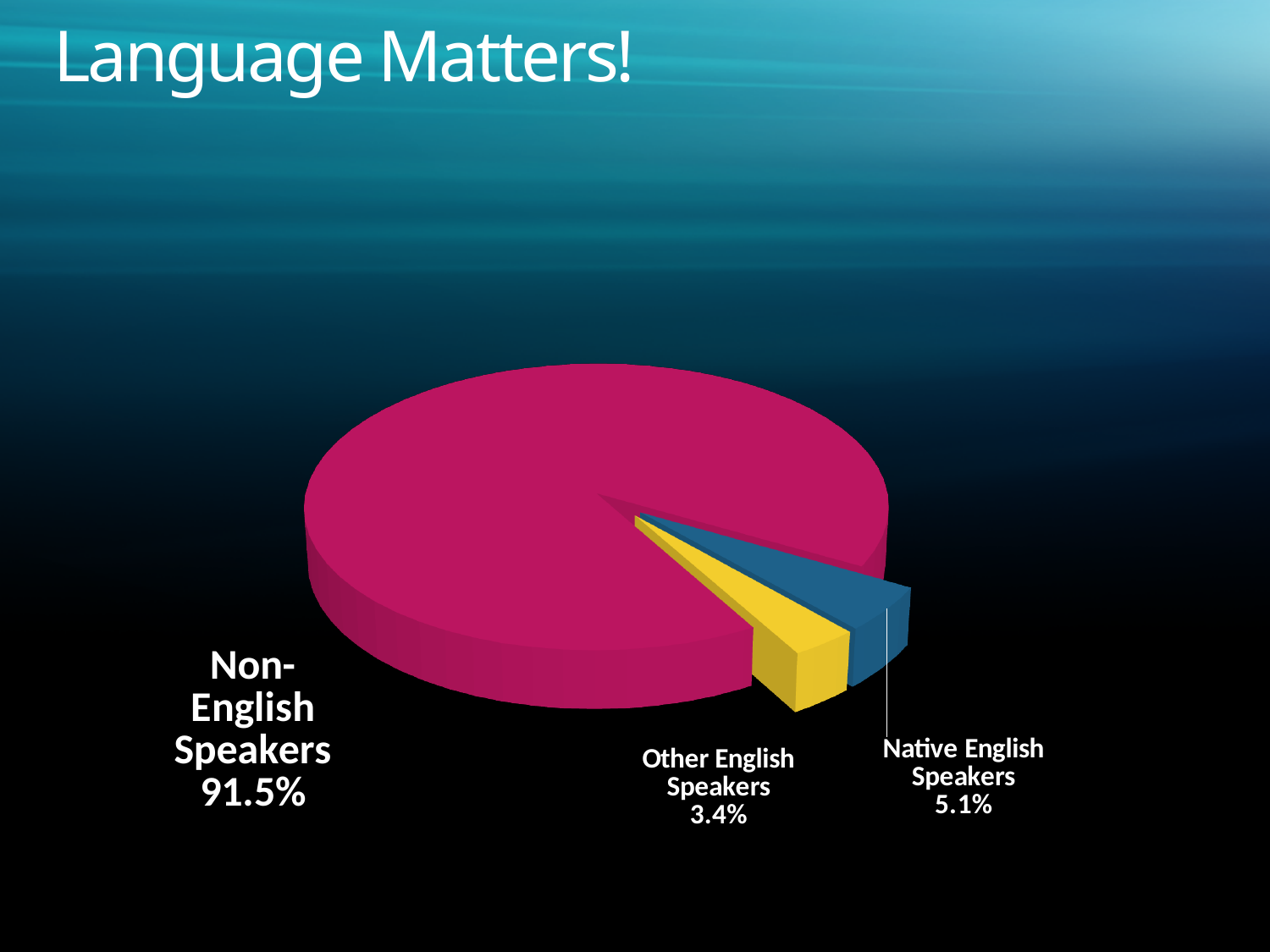
What is the difference in percentage points between the Native English Speakers slice and the Other English Speakers slice? 1.7% How many slices does the pie chart have? 3 What is the difference in percentage points between the Non-English Speakers slice and the Native English Speakers slice? 86.4% What share of the pie is labelled for Native English Speakers? 5.1% What is the title of the slide containing the pie chart? Language Matters! What kind of chart is shown on the slide? Pie chart What share of the pie is labelled for Non-English Speakers? 91.5% Which category has the largest slice of the pie? Non-English Speakers Which is larger, the slice for Native English Speakers or the slice for Other English Speakers? Native English Speakers What share of the pie is labelled for Other English Speakers? 3.4% Which category has the smallest slice of the pie? Other English Speakers What colour is the slice for Other English Speakers? Yellow